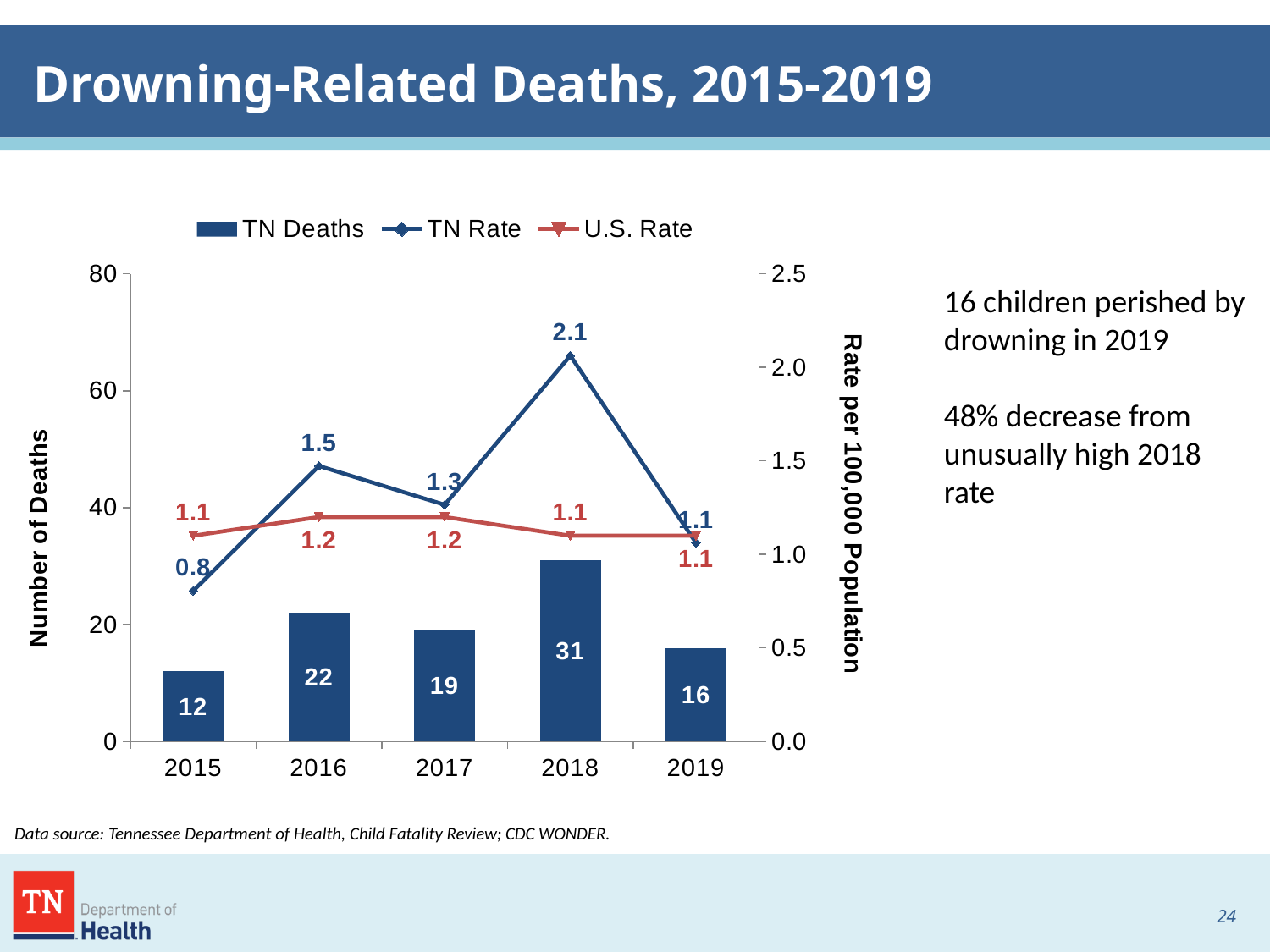
Did TN Deaths rise or fall from 2018 to 2019? fall What kind of chart is used to show the TN Deaths series? bar chart What was the TN Rate in 2016? 1.5 In which year were TN Deaths highest? 2018 In 2015, which was larger, the TN Rate or the U.S. Rate? U.S. Rate How many TN Deaths were recorded in 2018? 31 What is the difference between TN Deaths in 2018 and 2019? 15 Is the value for TN Deaths in 2016 greater or less than 20? greater What was the U.S. Rate in 2017? 1.2 How many series does the legend list? 3 How many years are shown on the x axis? 5 In which year was the TN Rate lowest? 2015